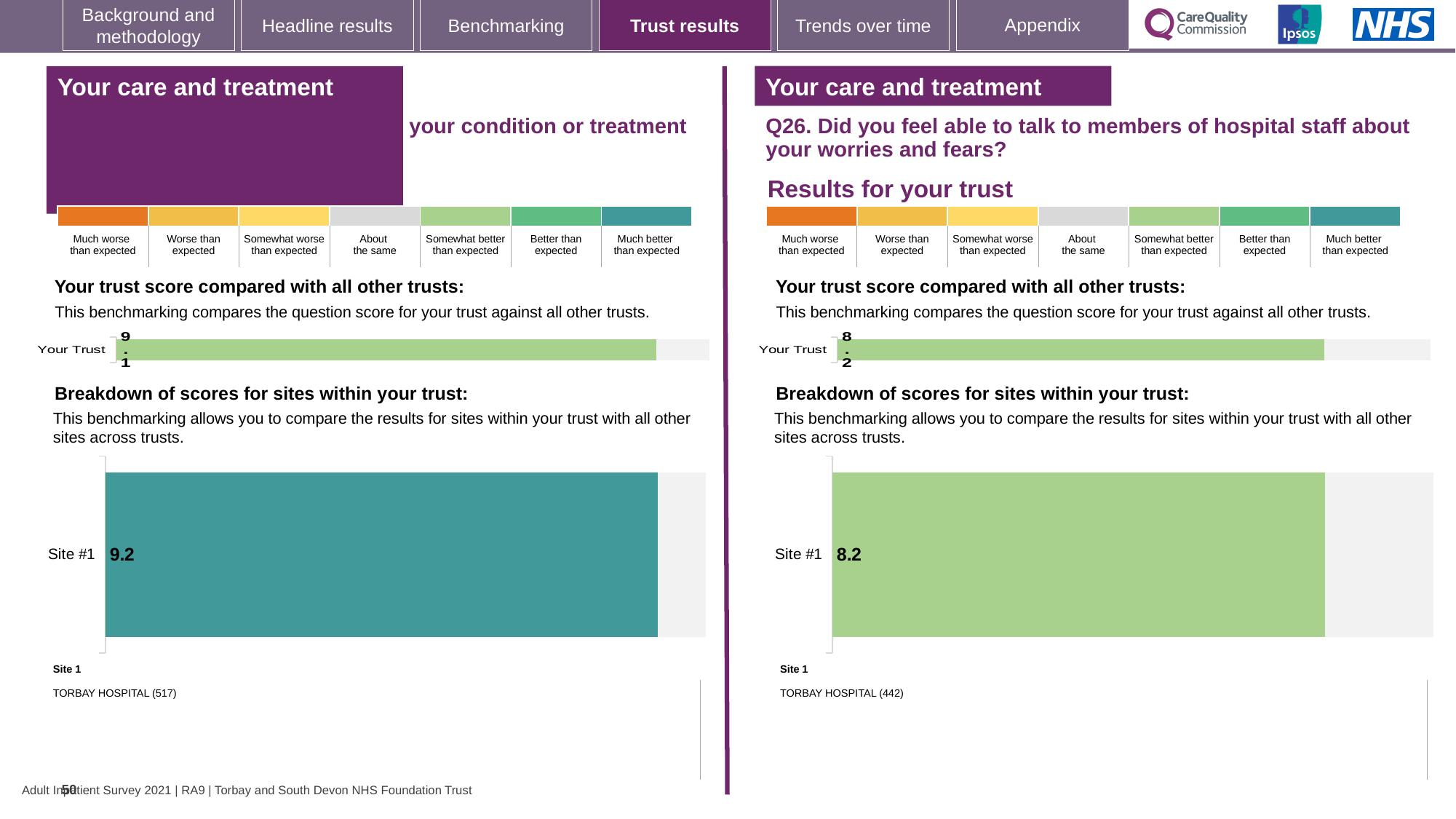
On the left half of the slide, is the Site #1 score greater or less than the Your Trust score? greater What is the difference between the Your Trust score on the left half of the slide and the Your Trust score on the right half (Q26)? 0.9 On the left half of the slide, what is the score shown for Site #1 in the breakdown of scores chart? 9.2 On the right half of the slide (Q26), which benchmarking category does the colour of the Site #1 bar correspond to? Somewhat better than expected On the right half of the slide (Q26), what is the score shown for Your Trust in the trust score chart? 8.2 On the right half of the slide (Q26), what is the score shown for Site #1 in the breakdown of scores chart? 8.2 On the left half of the slide, what is the score shown for Your Trust in the trust score chart? 9.1 What is the difference between the Site #1 score on the left half of the slide and the Site #1 score on the right half (Q26)? 1.0 How many sites are shown in the breakdown of scores chart on the left half of the slide? 1 On the left half of the slide, which site name is listed for Site 1 below the breakdown chart? TORBAY HOSPITAL (517) Which is larger: the Site #1 score on the left half of the slide or the Site #1 score on the right half (Q26)? Left half (9.2) What type of chart is used to show the Site #1 score on the right half of the slide? Bar chart